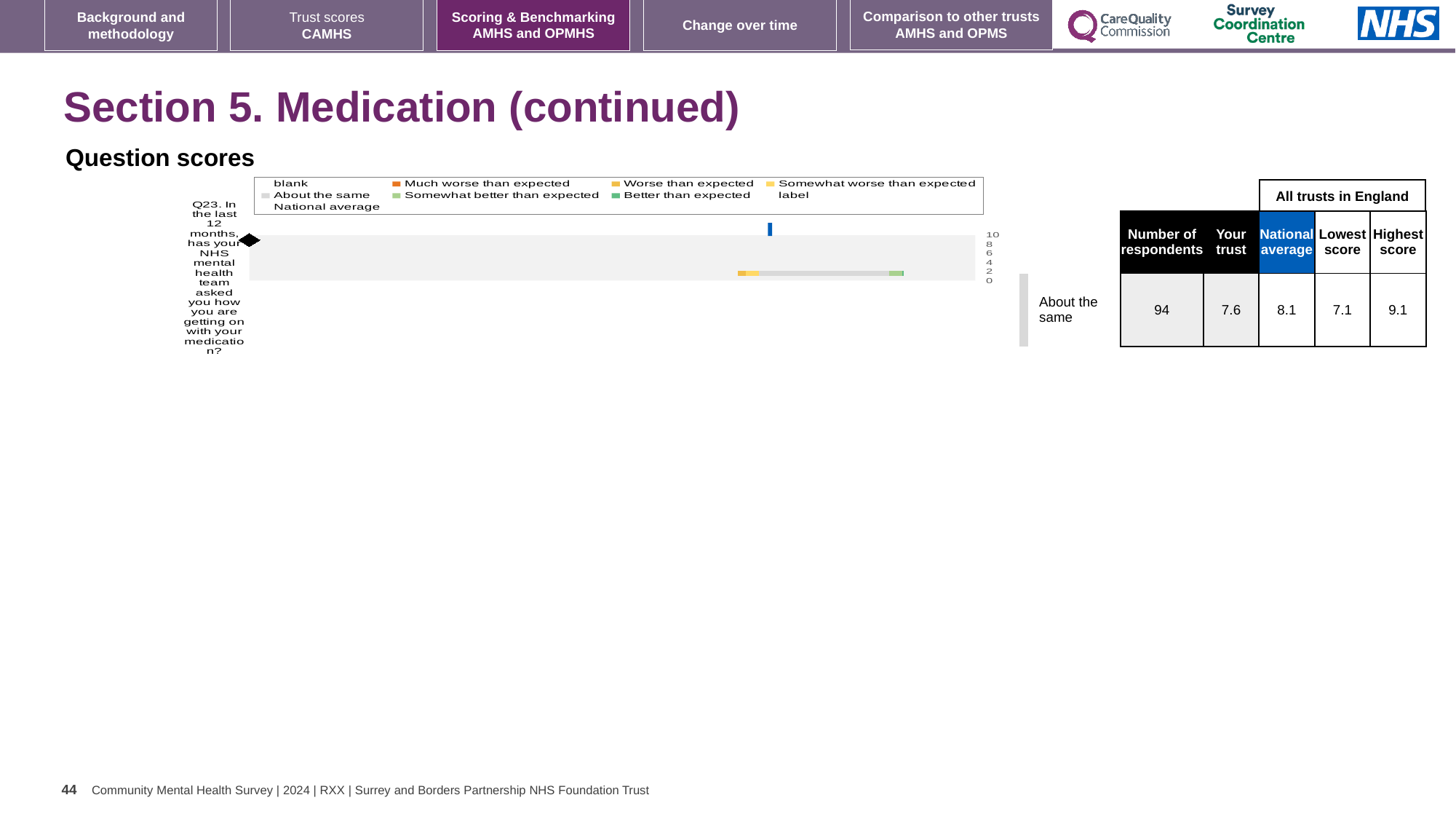
What kind of chart is shown under 'Question scores'? bar chart In the table beside the chart, what is the national average score for Q23? 8.1 What is the highest tick value shown on the chart's axis? 10 For Q23, what is the difference between the national average (8.1) and the 'Your trust' score (7.6)? 0.5 What benchmark category label is shown next to the Q23 bar? About the same How many survey questions are plotted as bars in the chart? 1 Which survey question does the chart plot? Q23. In the last 12 months, has your NHS mental health team asked you how you are getting on with your medication? For Q23, what is the difference between the highest score (9.1) and the lowest score (7.1) across all trusts in England? 2.0 For Q23, which is larger: the 'Your trust' score or the national average? National average How many entries does the chart's legend list? 9 In the table beside the chart, how many respondents answered Q23? 94 In the table beside the chart, what is the 'Your trust' score for Q23? 7.6